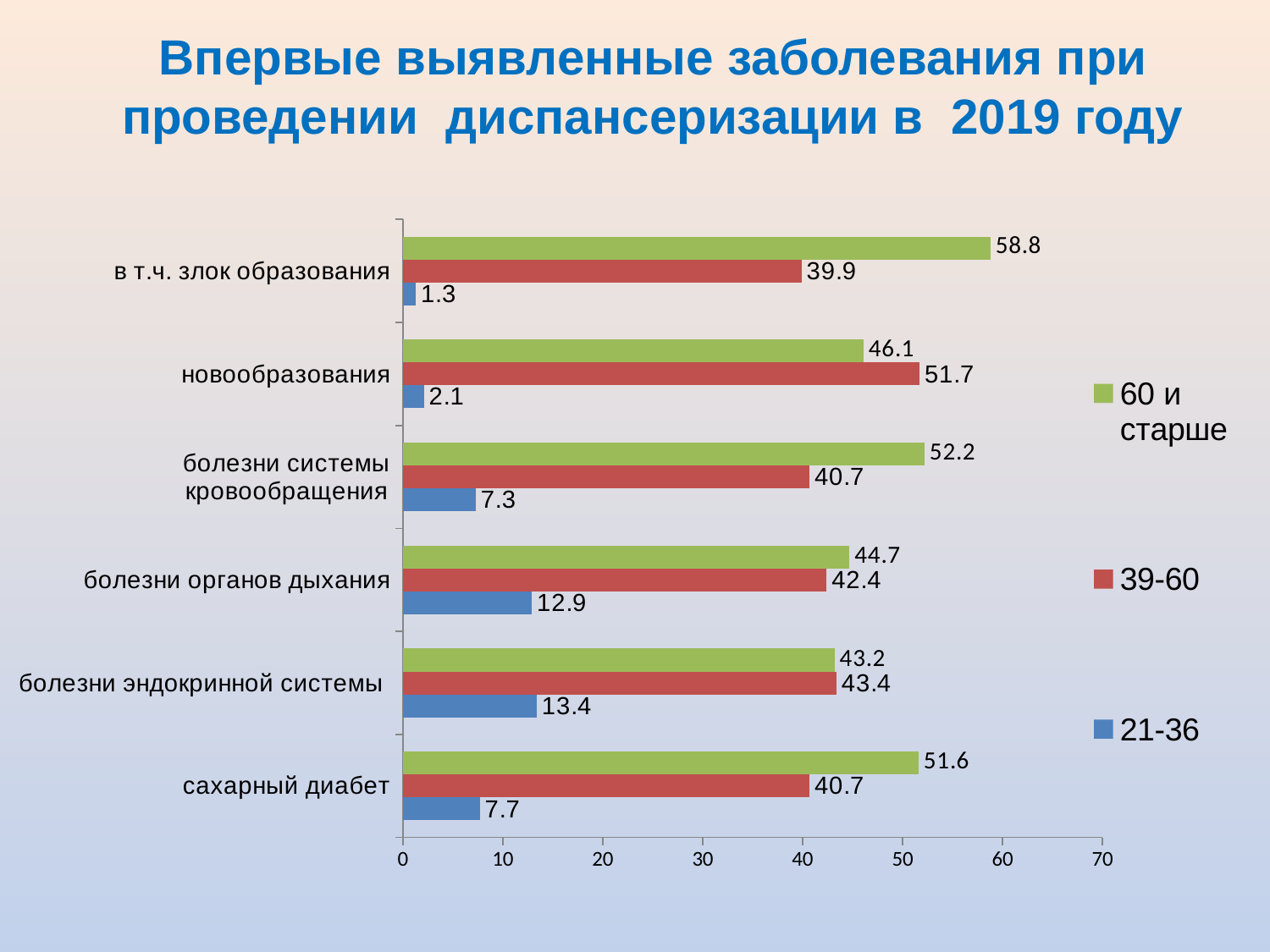
Is the value for "39-60" in "болезни системы кровообращения" greater or less than 50? less How many categories are shown on the chart? 6 What is the value for "21-36" in the category "болезни органов дыхания"? 12.9 What is the value for "60 и старше" in the category "в т.ч. злок образования"? 58.8 What is the value for "39-60" in the category "новообразования"? 51.7 For "новообразования", which series has the larger value: "60 и старше" or "39-60"? 39-60 How many series does the legend list? 3 Which colour represents the "21-36" series in the legend? blue Which category has the highest value for the "60 и старше" series? в т.ч. злок образования What is the difference between the "60 и старше" and "21-36" values for "сахарный диабет"? 43.9 What type of chart is shown on the slide? bar chart Which category has the lowest value for the "21-36" series? в т.ч. злок образования